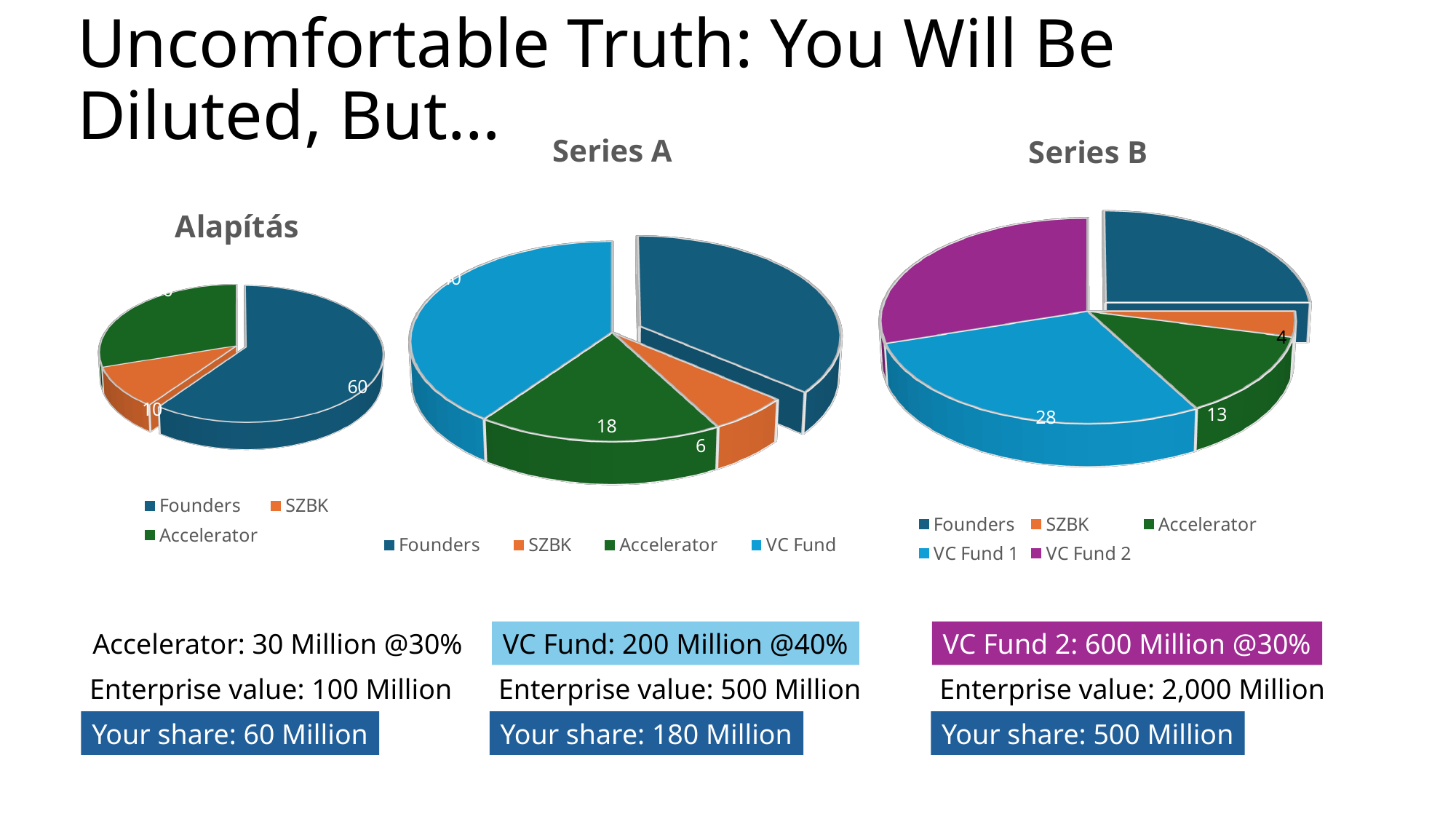
In the Alapítás pie chart, what is the value for SZBK? 10 How many categories does the Alapítás pie chart have? 3 In the Series A pie chart, what is the difference between the Accelerator value and the SZBK value? 12 How many entries does the legend of the Series B pie chart list? 5 In the Series A pie chart, what is the value for Accelerator? 18 In the Alapítás pie chart, what is the value for Founders? 60 In the Series A pie chart, what is the value for SZBK? 6 In the Series B pie chart, what is the value for SZBK? 4 What kind of chart is the Series A chart? Pie chart In the Series B pie chart, what is the value for Accelerator? 13 In the Series B pie chart, which category has the smallest slice? SZBK In the Series B pie chart, what is the value for VC Fund 1? 28